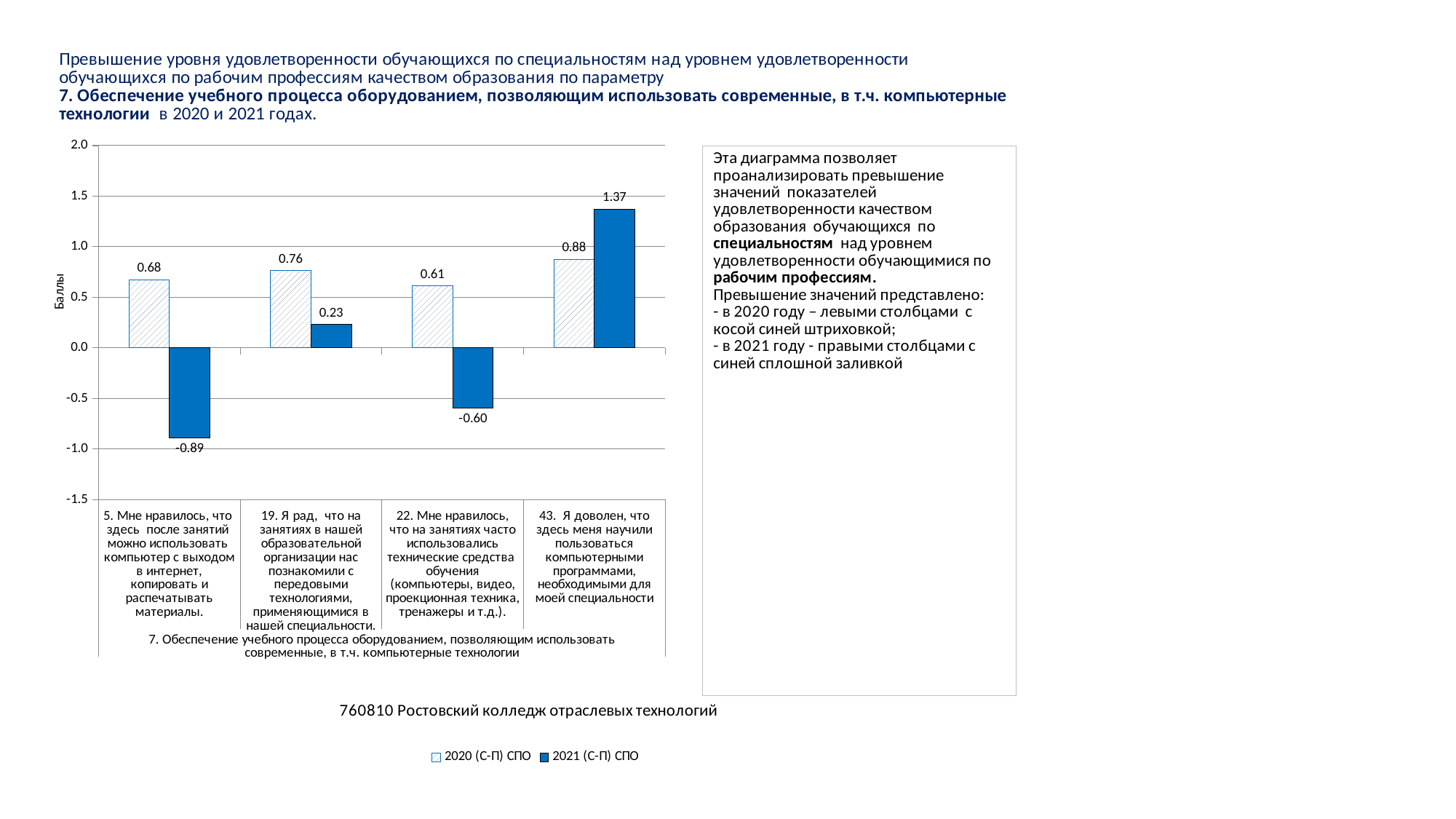
What is the value of the 2020 (С-П) СПО series for item 5 (using a computer with internet access after classes)? 0.68 What type of chart is shown on the slide? Bar chart What is the value of the 2021 (С-П) СПО series for item 5 (using a computer with internet access after classes)? -0.89 Which item has the lowest value in the 2021 (С-П) СПО series? 5. Мне нравилось, что здесь после занятий можно использовать компьютер с выходом в интернет, копировать и распечатывать материалы. For item 19, which series has the larger value, 2020 (С-П) СПО or 2021 (С-П) СПО? 2020 (С-П) СПО What is the difference between the 2021 and 2020 values for item 43? 0.49 What is the value of the 2021 (С-П) СПО series for item 43 (learned to use computer programs needed for my specialty)? 1.37 Which item has the highest value in the 2021 (С-П) СПО series? 43. Я доволен, что здесь меня научили пользоваться компьютерными программами, необходимыми для моей специальности How many series does the chart legend list? 2 What is the value of the 2020 (С-П) СПО series for item 22 (technical teaching aids often used in classes)? 0.61 What is the label of the vertical axis of the chart? Баллы How many items (categories) are shown on the x axis of the chart? 4